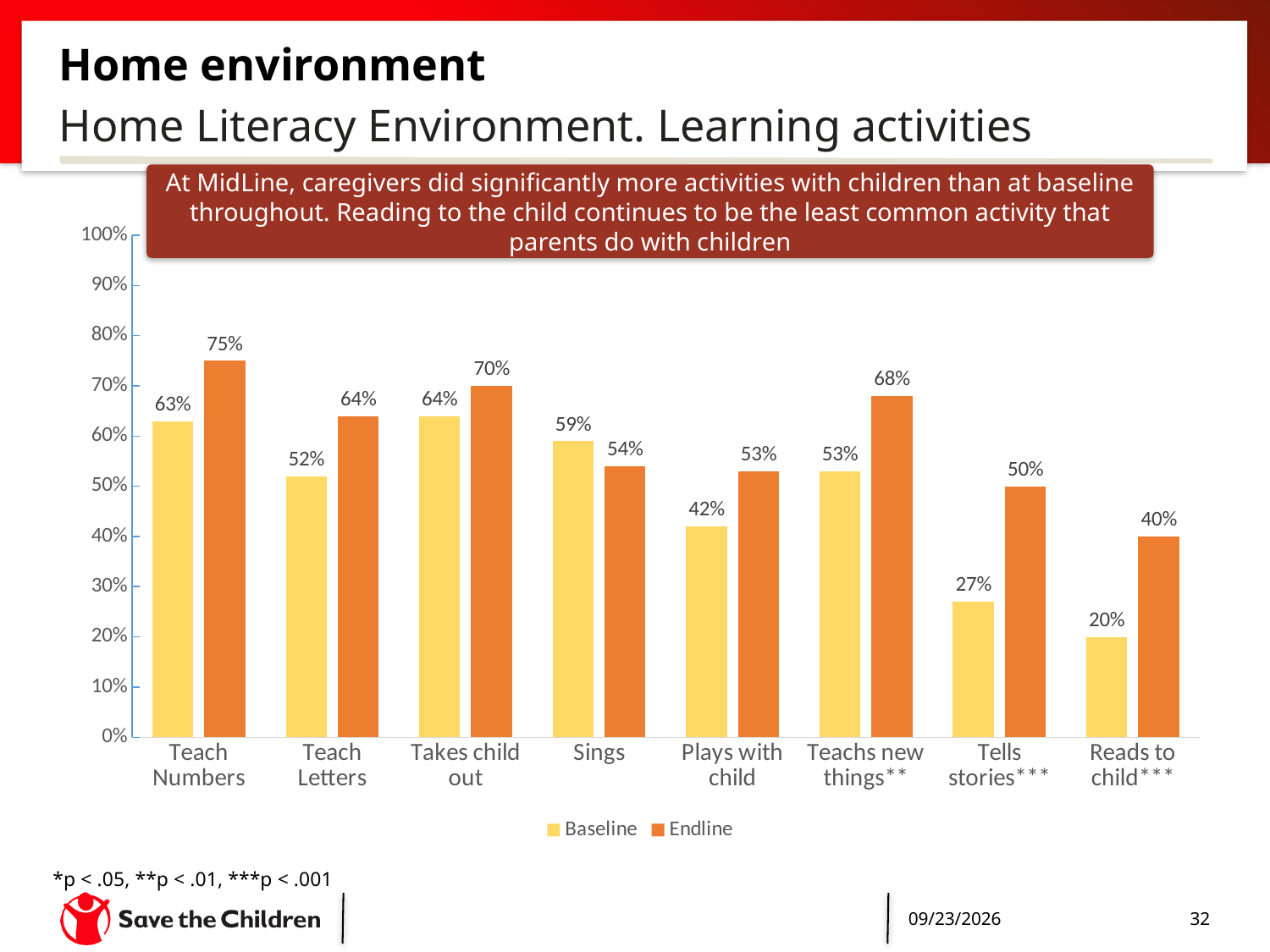
What is the Baseline value for Reads to child***? 20% What is the Baseline value for Plays with child? 42% What kind of chart is shown on the slide? Bar chart What is the difference between the Endline and Baseline values for Tells stories***? 23% What is the Endline value for Teach Numbers? 75% Is the Endline value for Teachs new things** greater or less than 60%? greater Which category has the highest Endline value? Teach Numbers Which colour represents the Endline series in the legend? Orange How many series does the legend list? 2 Which category has the lowest Baseline value? Reads to child*** How many activity categories are shown on the x axis? 8 Which is larger for Sings: the Baseline value or the Endline value? Baseline